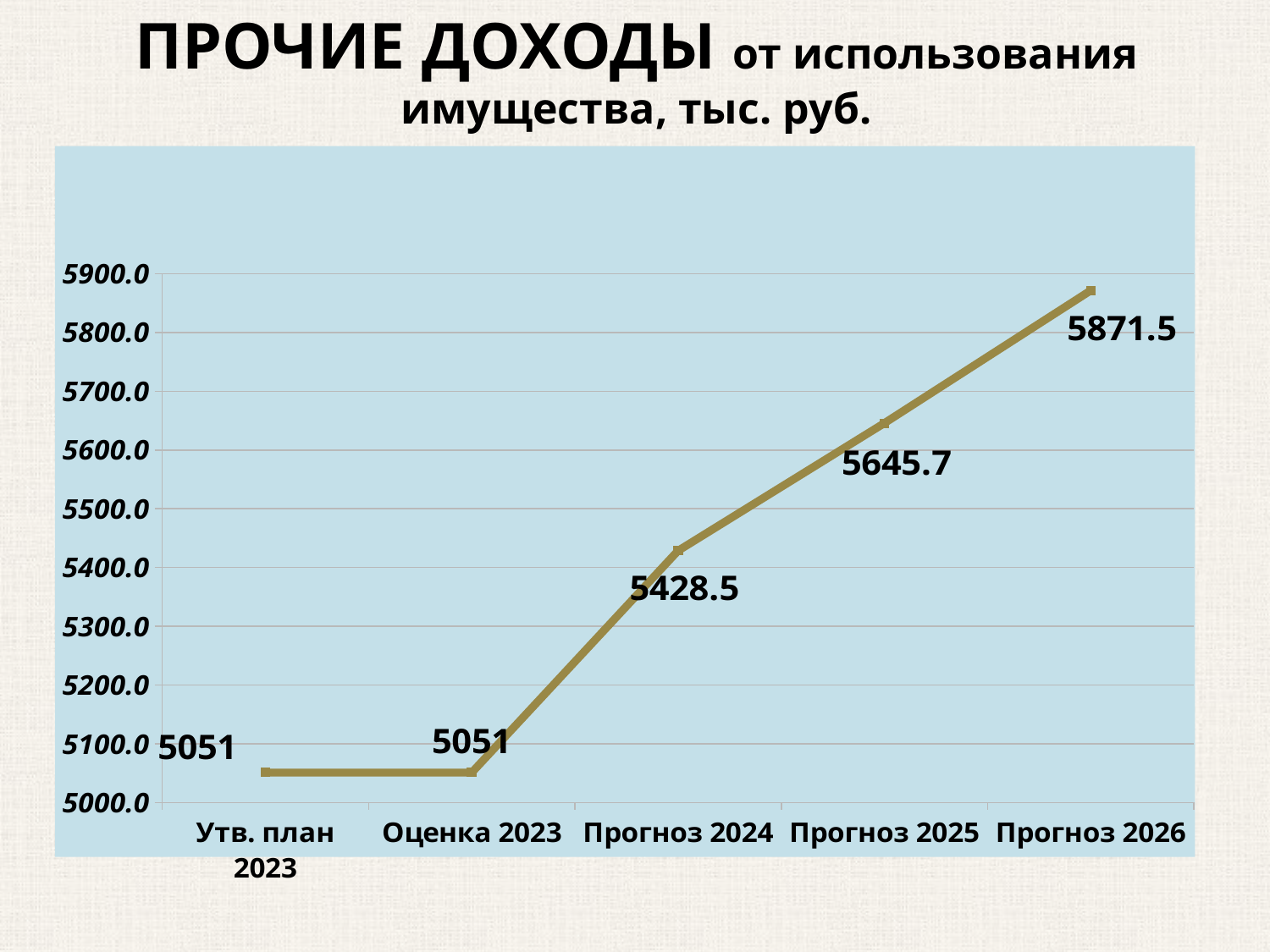
What is the value for Прогноз 2026? 5871.5 Do the values rise or fall from Оценка 2023 to Прогноз 2026? rise What is the difference between the values for Прогноз 2024 and Оценка 2023? 377.5 Is the value for Прогноз 2025 greater or less than 5600.0? greater Which category has the highest value? Прогноз 2026 How many categories are shown on the x axis? 5 Which is larger, the value for Прогноз 2025 or the value for Прогноз 2024? Прогноз 2025 What is the value for Оценка 2023? 5051 What is the value for Прогноз 2024? 5428.5 What is the difference between the values for Прогноз 2026 and Прогноз 2025? 225.8 What is the value for Прогноз 2025? 5645.7 What kind of chart is shown on the slide? line chart